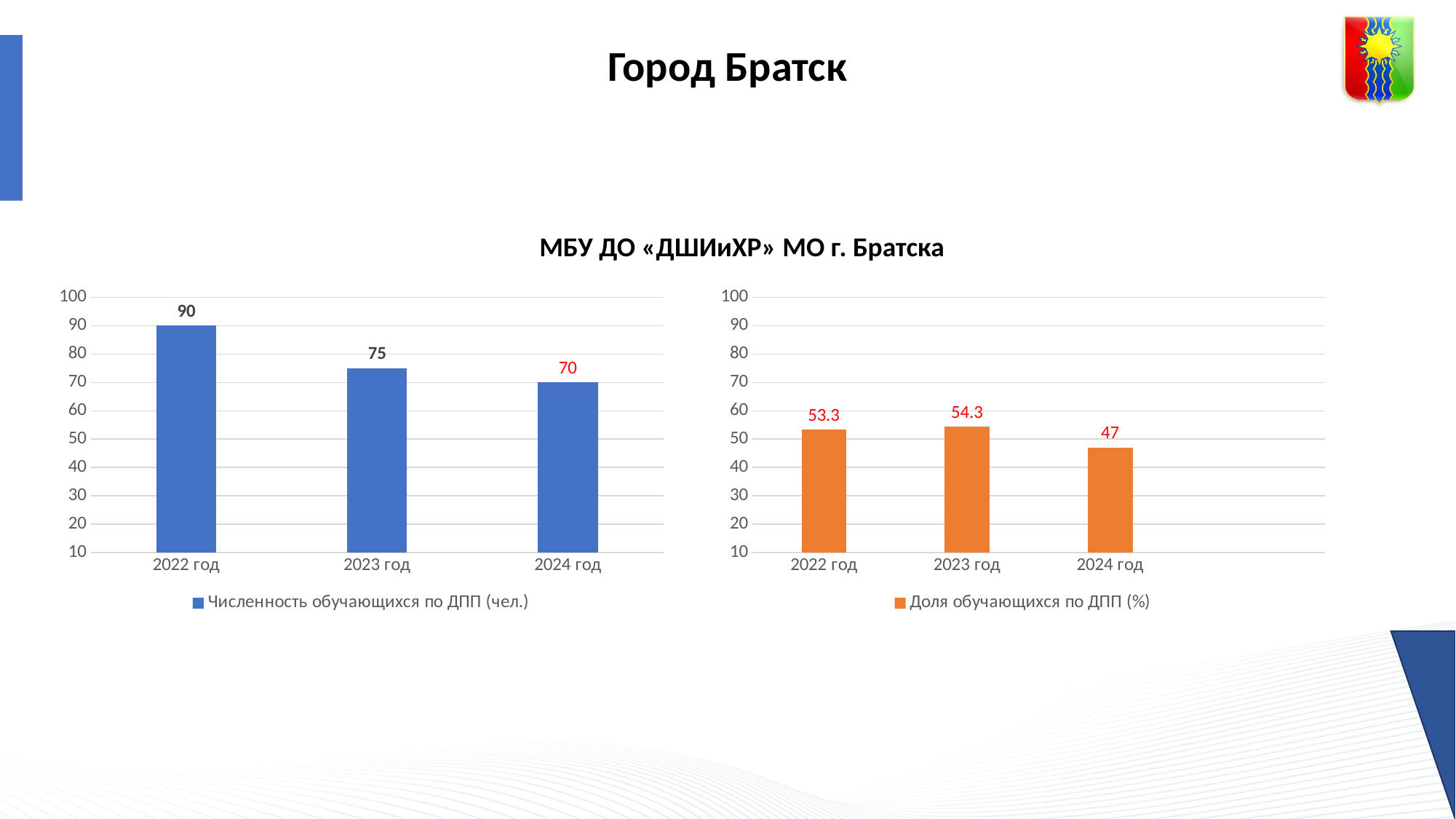
In the right chart (Доля обучающихся по ДПП (%)), what is the value for 2023 год? 54.3 In the left chart (Численность обучающихся по ДПП (чел.)), what is the difference between the values for 2022 год and 2023 год? 15 How many categories are shown on the x axis of the left chart (Численность обучающихся по ДПП (чел.))? 3 In the right chart (Доля обучающихся по ДПП (%)), what is the difference between the values for 2023 год and 2024 год? 7.3 In the left chart (Численность обучающихся по ДПП (чел.)), which year has the highest value? 2022 год In the left chart (Численность обучающихся по ДПП (чел.)), do the values rise or fall from 2022 год to 2024 год? Fall In the left chart (Численность обучающихся по ДПП (чел.)), what is the value for 2022 год? 90 What type of chart is the right chart (Доля обучающихся по ДПП (%))? Bar chart In the right chart (Доля обучающихся по ДПП (%)), which year has the lowest value? 2024 год In the right chart (Доля обучающихся по ДПП (%)), which is larger: the value for 2022 год or 2024 год? 2022 год In the right chart (Доля обучающихся по ДПП (%)), what is the value for 2024 год? 47 In the left chart (Численность обучающихся по ДПП (чел.)), what is the value for 2024 год? 70